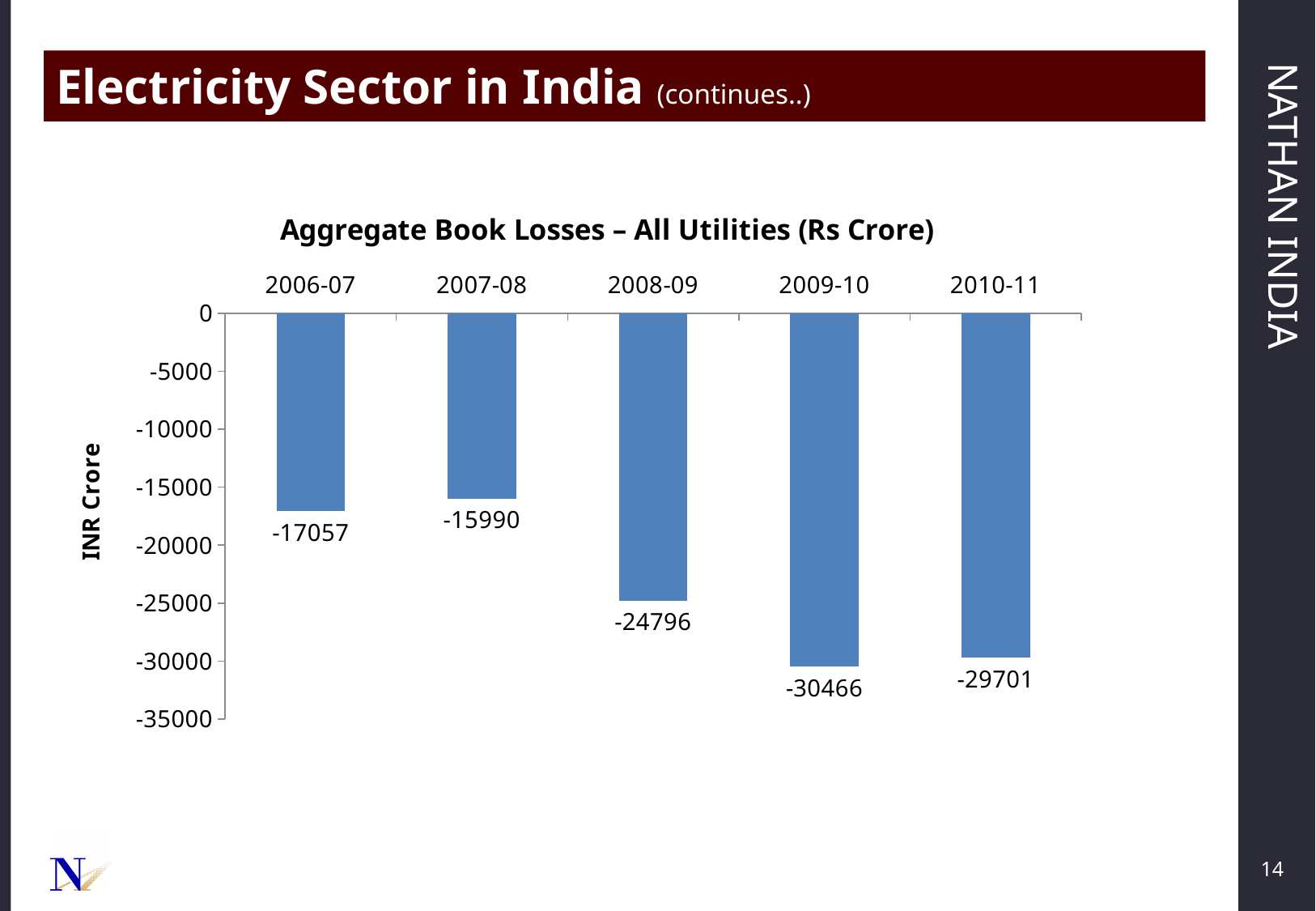
What kind of chart is this? Bar chart What is the value for 2009-10? -30466 What is the value for 2006-07? -17057 What is the value for 2008-09? -24796 Which year has the lowest value (largest loss)? 2009-10 What is the value for 2010-11? -29701 What is the difference between the values for 2009-10 and 2010-11? 765 How many years are shown on the chart? 5 Which is larger, the value for 2006-07 or the value for 2007-08? 2007-08 Which year has the highest value (smallest loss)? 2007-08 What is the difference between the values for 2008-09 and 2007-08? 8806 What is the label on the vertical axis? INR Crore